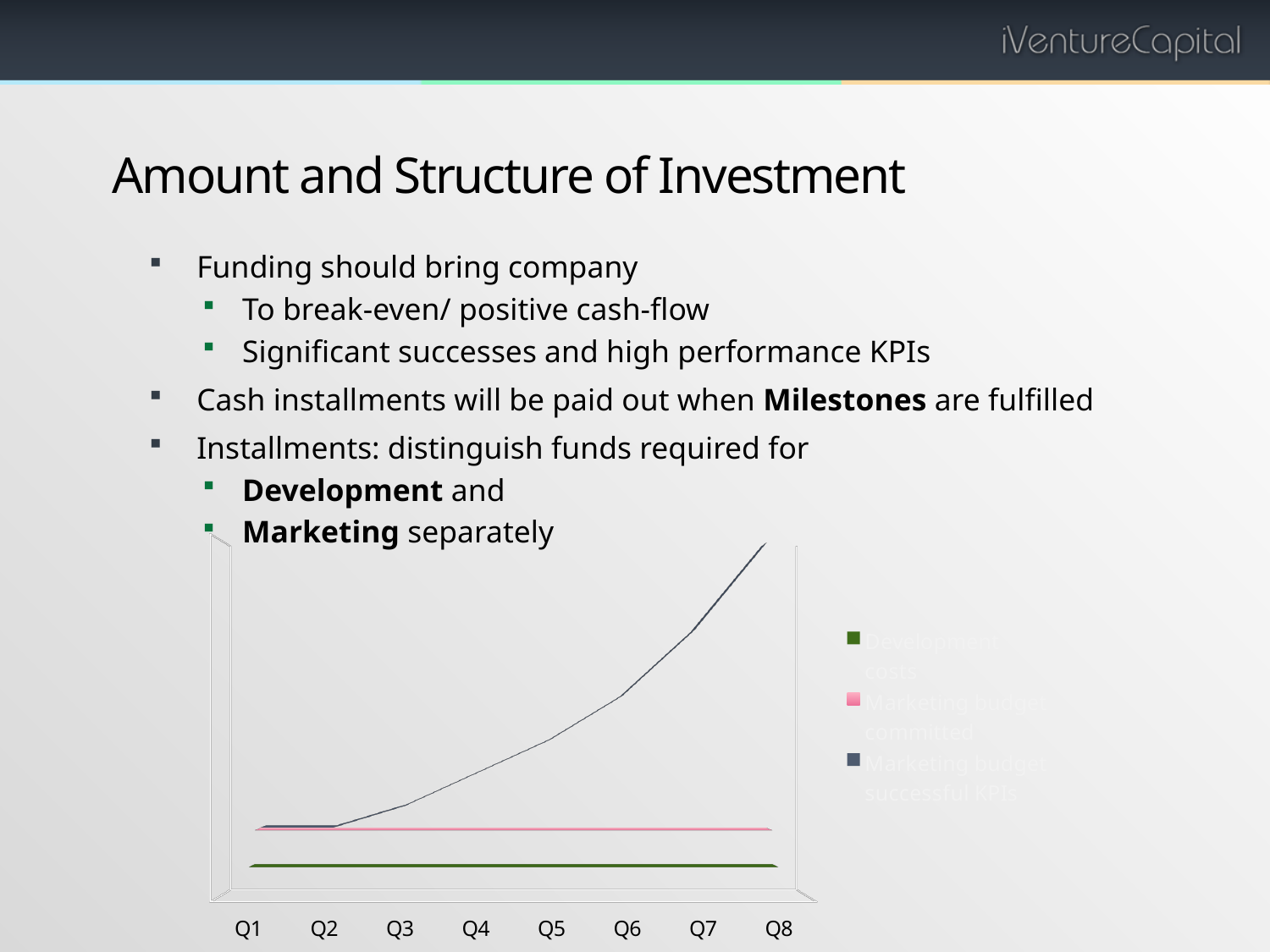
At Q8, which is larger: Marketing budget successful KPIs or Marketing budget committed? Marketing budget successful KPIs At Q5, which is larger: Marketing budget committed or Development costs? Marketing budget committed Which series has the lowest value at Q8? Development costs How many quarters are shown on the x axis of the chart? 8 Does the Marketing budget successful KPIs line rise or fall from Q1 to Q8? Rises Does the Development costs line rise, fall or stay flat from Q1 to Q8? Stays flat Does the Marketing budget committed line rise, fall or stay flat from Q1 to Q8? Stays flat Which series has the highest value at Q8? Marketing budget successful KPIs How many series does the chart's legend list? 3 Which series is shown in pink in the chart's legend? Marketing budget committed What is the first category label on the x axis of the chart? Q1 What kind of chart is shown on the slide? Line chart